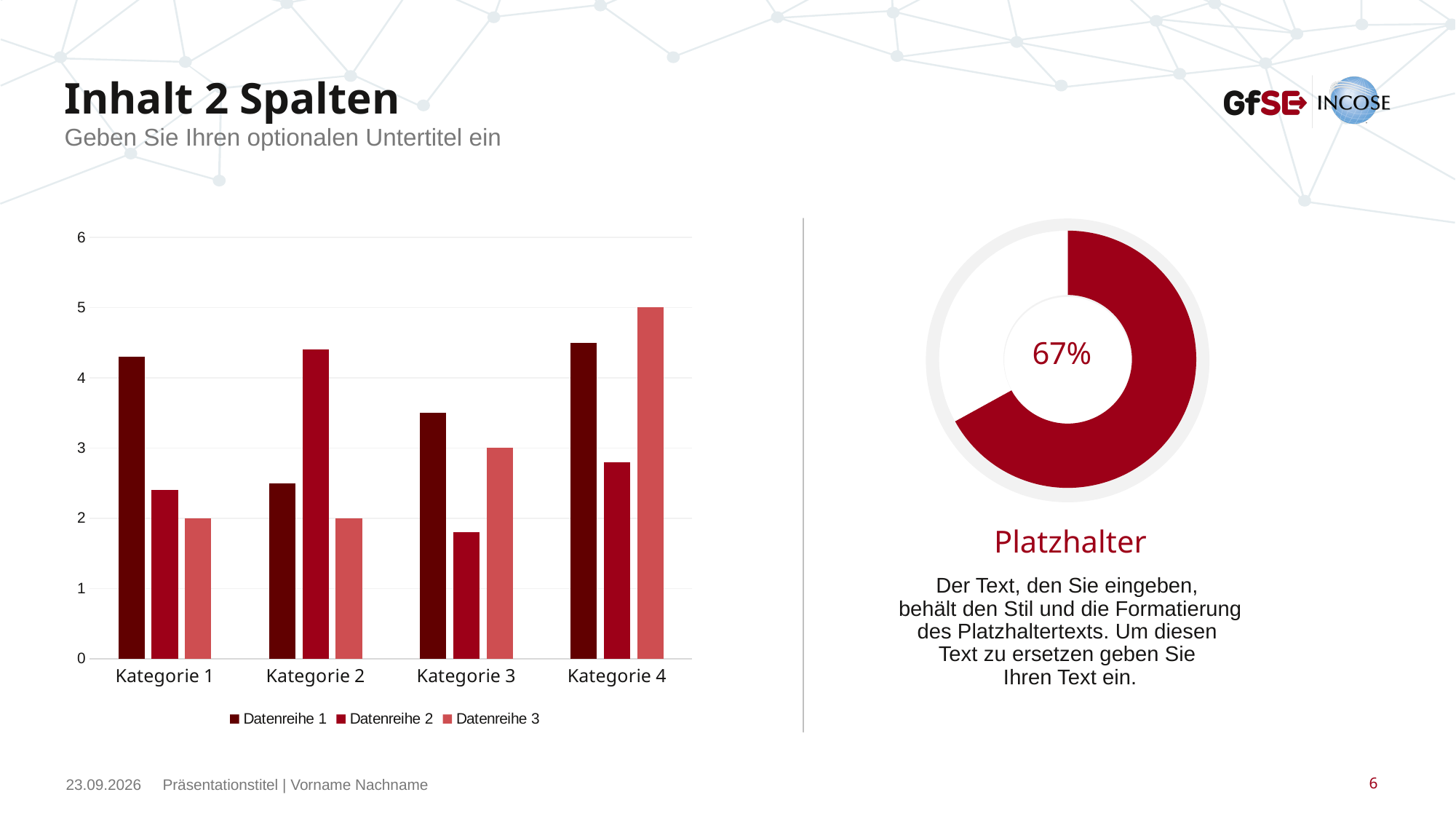
In the bar chart on the left, which category has the lowest value for Datenreihe 2? Kategorie 3 In the bar chart on the left, what is the value of Datenreihe 3 for Kategorie 4? 5 In the bar chart on the left, which is larger for Kategorie 2: Datenreihe 1 or Datenreihe 2? Datenreihe 2 In the bar chart on the left, is the value of Datenreihe 2 for Kategorie 3 greater or less than 2? less In the bar chart on the left, which category has the highest value for Datenreihe 3? Kategorie 4 In the bar chart on the left, how many categories are shown on the x axis? 4 In the bar chart on the left, how many series does the legend list? 3 In the bar chart on the left, is the value of Datenreihe 1 for Kategorie 1 greater or less than 4? greater In the bar chart on the left, what is the value of Datenreihe 3 for Kategorie 1? 2 In the bar chart on the left, what is the value of Datenreihe 3 for Kategorie 3? 3 What kind of chart is on the left side of the slide? bar chart What percentage is shown in the centre of the donut chart on the right side of the slide? 67%